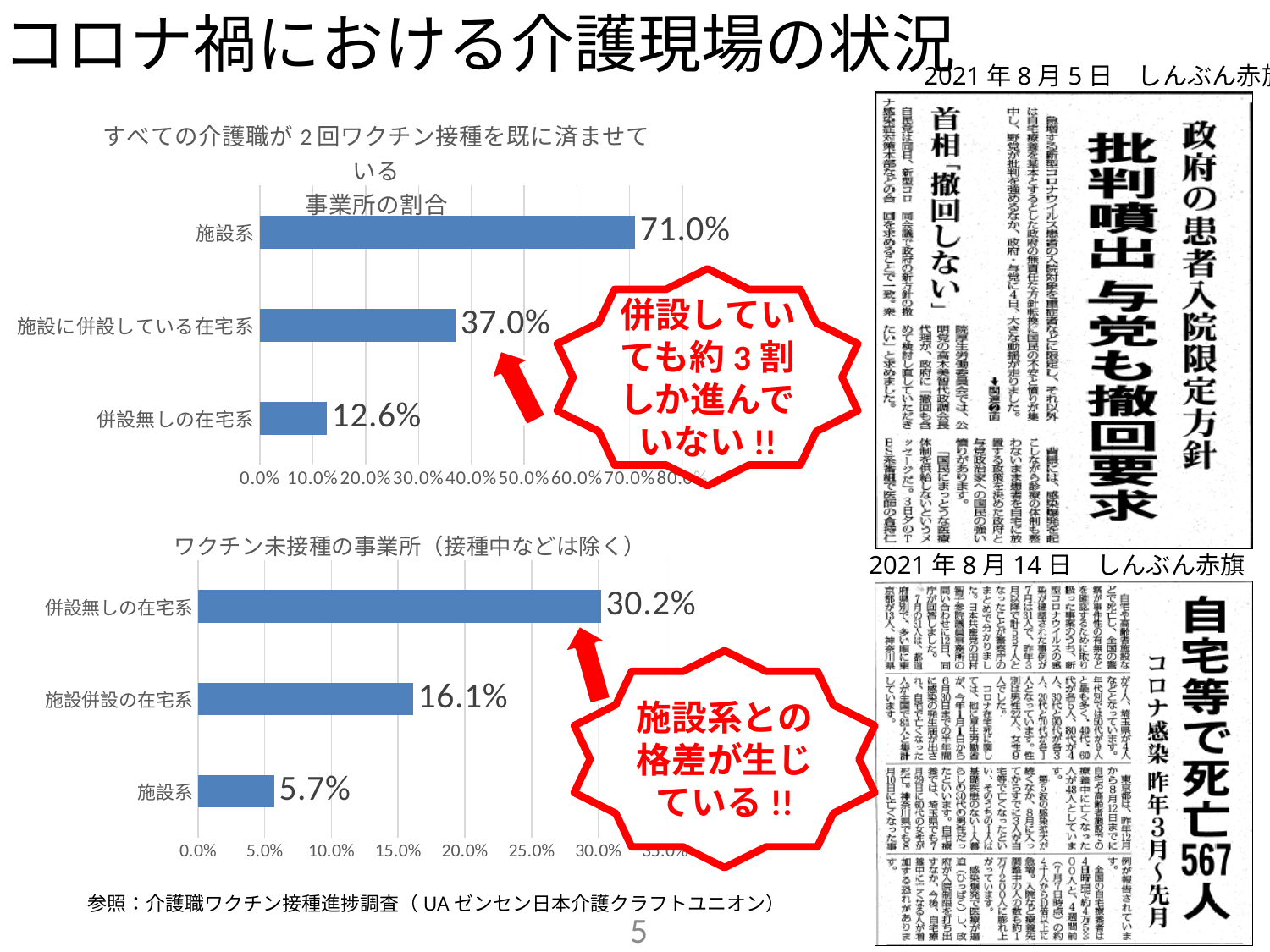
In the top chart (すべての介護職が2回ワクチン接種を既に済ませている事業所の割合), what is the difference between 施設系 and 併設無しの在宅系? 58.4% In the bottom chart (ワクチン未接種の事業所), what is the value for 施設系? 5.7% What type of chart is the bottom chart (ワクチン未接種の事業所)? Bar chart In the top chart (すべての介護職が2回ワクチン接種を既に済ませている事業所の割合), what is the value for 施設に併設している在宅系? 37.0% In the top chart (すべての介護職が2回ワクチン接種を既に済ませている事業所の割合), how many categories are shown? 3 In the bottom chart (ワクチン未接種の事業所), which category has the highest value? 併設無しの在宅系 In the top chart (すべての介護職が2回ワクチン接種を既に済ませている事業所の割合), what is the value for 施設系? 71.0% In the top chart (すべての介護職が2回ワクチン接種を既に済ませている事業所の割合), is the value for 施設系 greater or less than 70.0%? greater In the bottom chart (ワクチン未接種の事業所), what is the difference between 施設併設の在宅系 and 施設系? 10.4% In the bottom chart (ワクチン未接種の事業所), which is larger: 施設併設の在宅系 or 施設系? 施設併設の在宅系 In the bottom chart (ワクチン未接種の事業所), what is the value for 併設無しの在宅系? 30.2% In the top chart (すべての介護職が2回ワクチン接種を既に済ませている事業所の割合), which category has the lowest value? 併設無しの在宅系